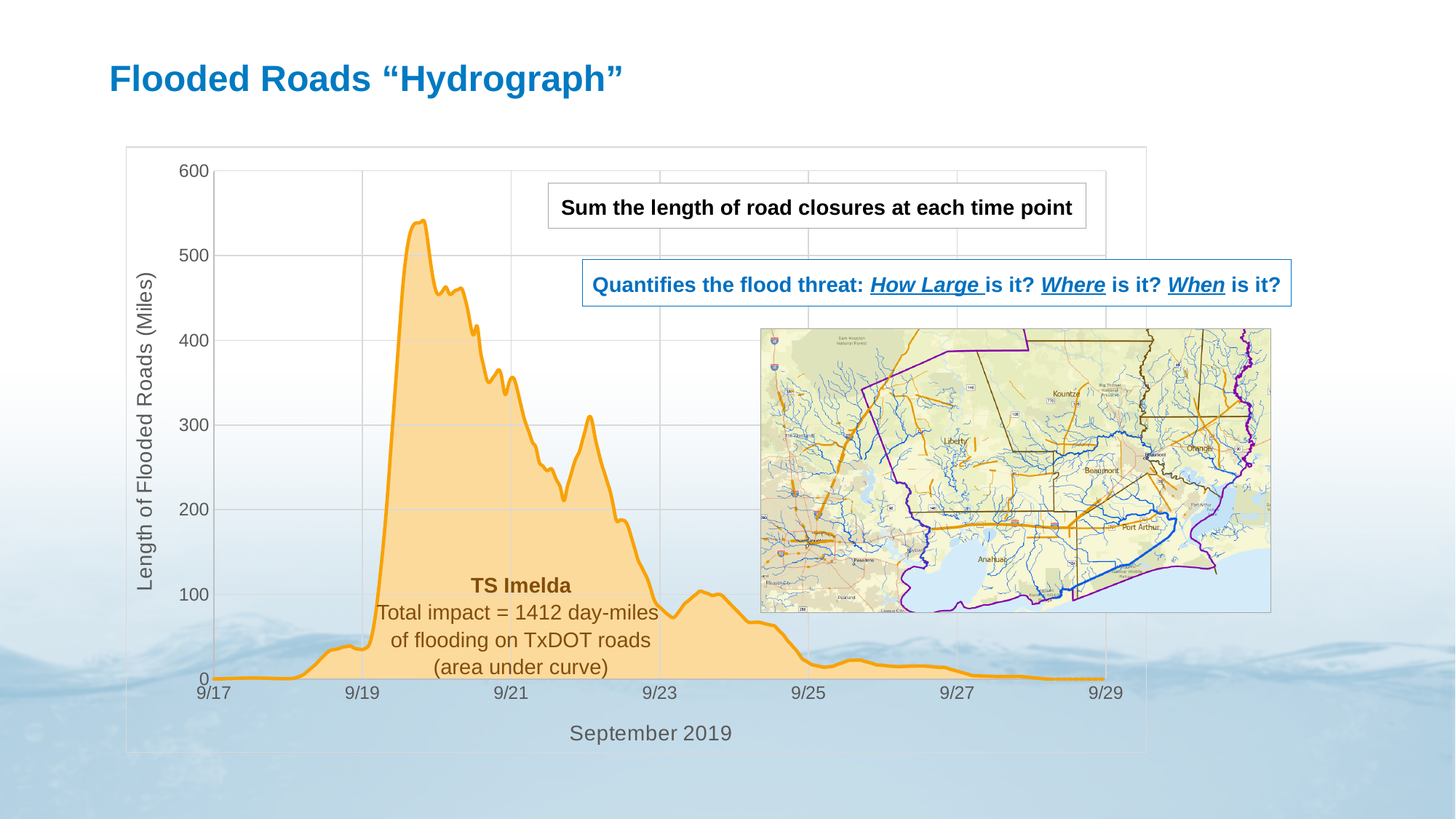
Do the values of flooded road length rise or fall between 9/23 and 9/29? fall Is the secondary peak of flooded road length around 9/22 greater or less than 200 miles? greater What kind of chart is shown on the slide? area chart What is the first date shown on the x-axis? 9/17 Is the value of flooded road length on 9/25 greater or less than 100 miles? less Is the peak value of flooded road length greater or less than 500 miles? greater What is the label of the y-axis? Length of Flooded Roads (Miles) What is the title of the slide's chart? Flooded Roads "Hydrograph" What is the highest tick value shown on the y-axis? 600 What total impact in day-miles is stated for TS Imelda on the chart? 1412 day-miles Which storm is named on the chart as the cause of the flooding? TS Imelda